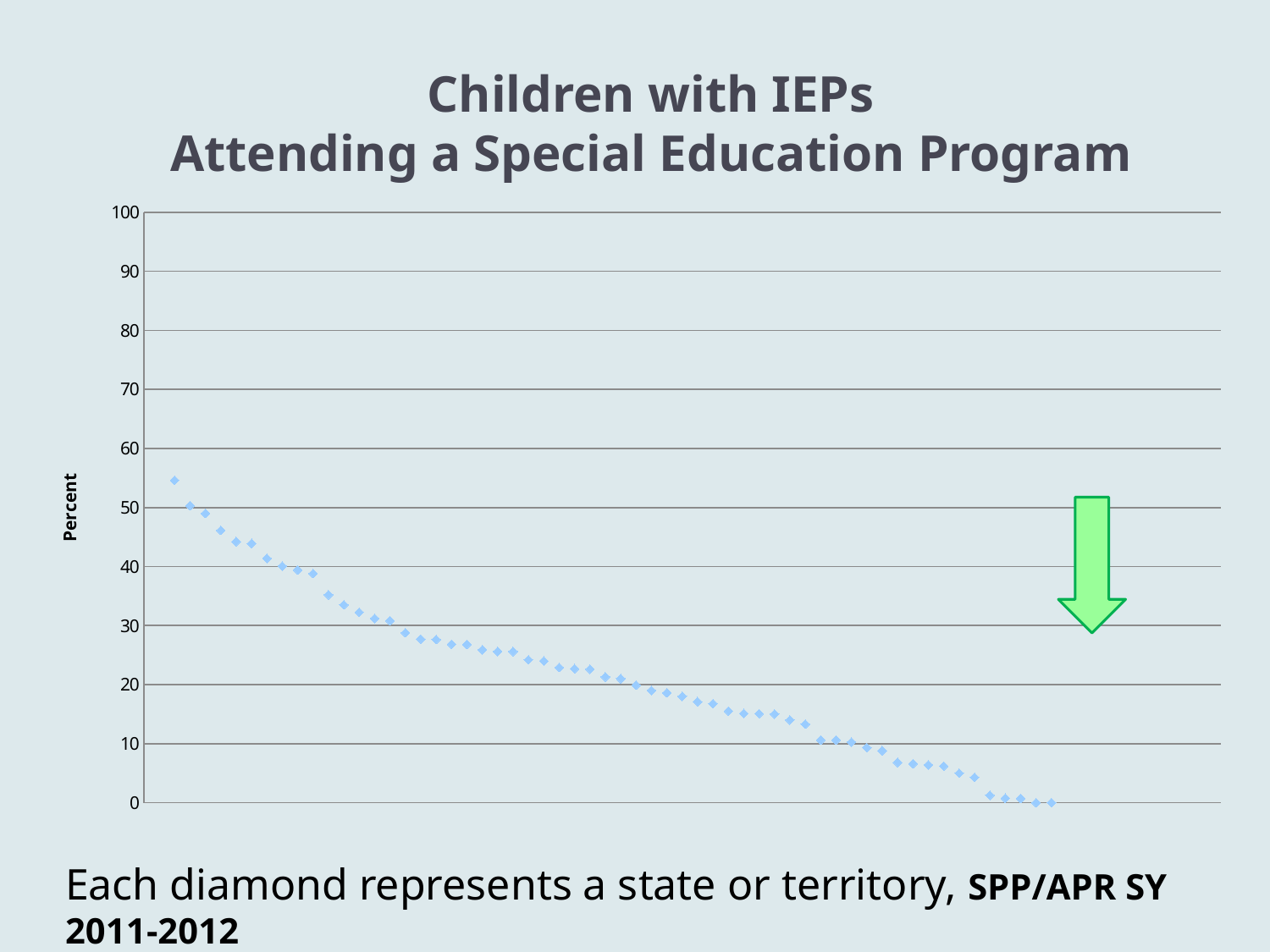
Is the leftmost point's value greater or less than 40? greater What is the interval between tick marks on the vertical axis? 10 Is the highest plotted value greater or less than 60? less Do the plotted values rise or fall from left to right along the x axis? fall Is the highest plotted value greater or less than 50? greater What is the maximum value shown on the vertical axis? 100 What is the label on the vertical axis of the chart? Percent What is the title of the chart? Children with IEPs Attending a Special Education Program What kind of chart is shown on the slide? scatter chart